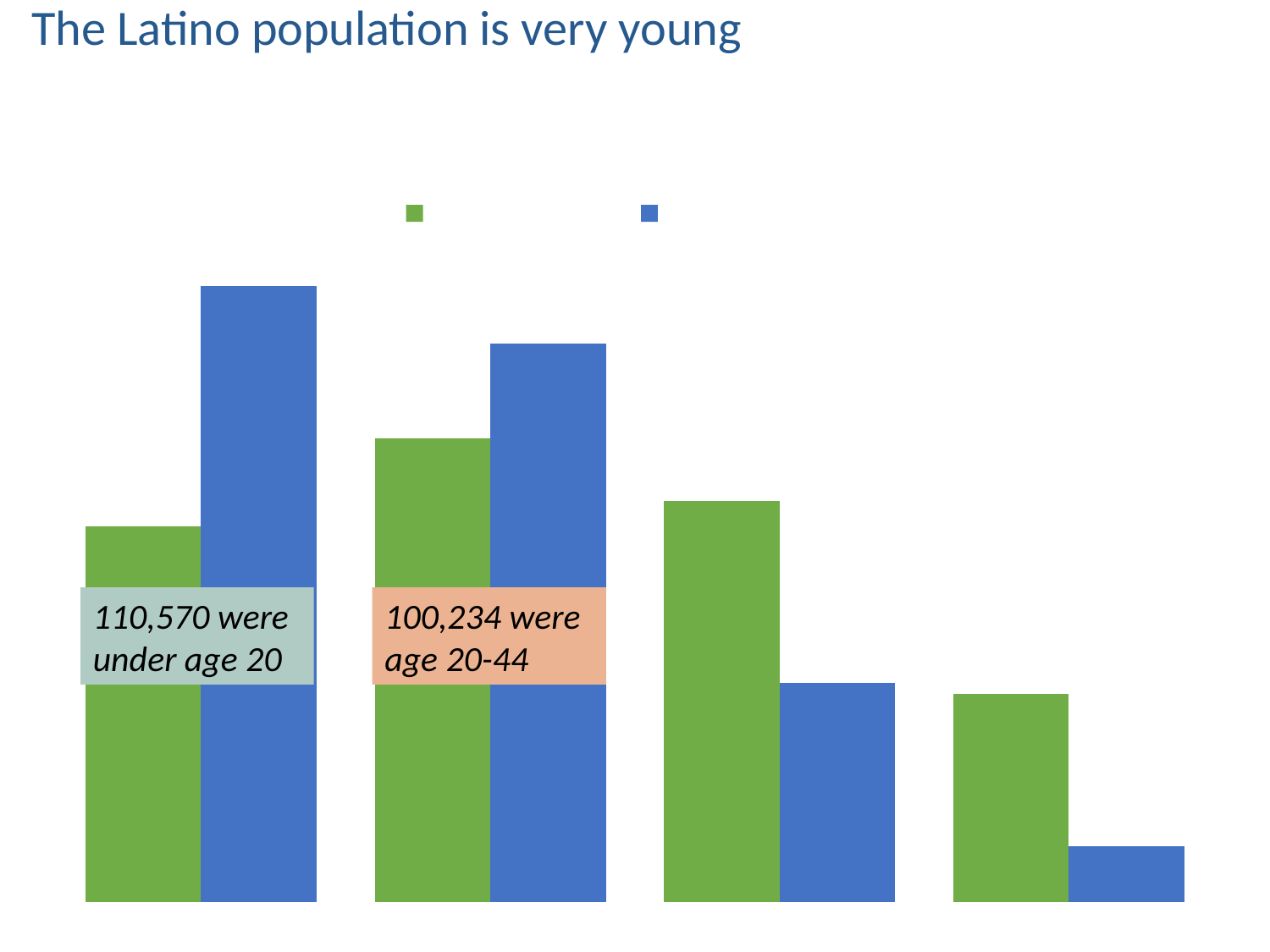
In the rightmost group of bars, which bar is taller, the green one or the blue one? the green one How many series does the legend show? 2 According to the annotation on the chart, how many were under age 20? 110,570 Which group of bars contains the tallest bar on the chart? the leftmost group In the third group of bars from the left, which bar is taller, the green one or the blue one? the green one What kind of chart is shown on the slide? bar chart According to the annotation on the chart, how many were age 20-44? 100,234 What is the title of the slide? The Latino population is very young In the leftmost group of bars, which bar is taller, the green one or the blue one? the blue one Which bar is the shortest on the chart? the blue bar in the rightmost group How many groups of bars does the chart have? 4 Do the blue bars rise or fall from left to right across the chart? fall